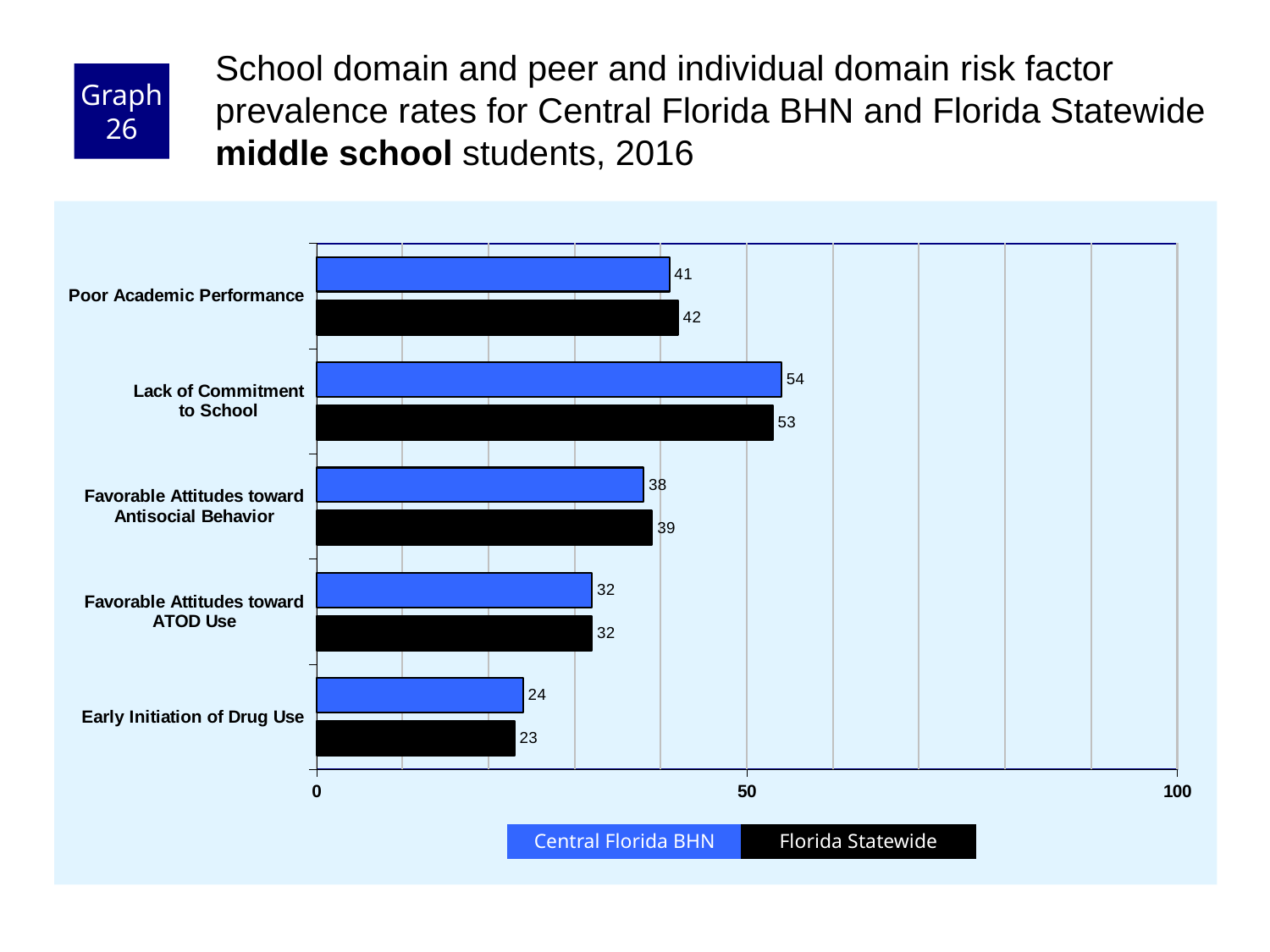
What is the difference between the Central Florida BHN values for Poor Academic Performance and Early Initiation of Drug Use? 17 What is the Central Florida BHN value for Lack of Commitment to School? 54 Which risk factor has the lowest Florida Statewide value? Early Initiation of Drug Use What is the Florida Statewide value for Early Initiation of Drug Use? 23 What is the difference between the Central Florida BHN and Florida Statewide values for Lack of Commitment to School? 1 What kind of chart is shown on the slide? bar chart How many risk factor categories are shown on the chart? 5 How many series does the legend list? 2 What is the Florida Statewide value for Favorable Attitudes toward Antisocial Behavior? 39 Which risk factor has the highest Central Florida BHN value? Lack of Commitment to School Which colour represents Florida Statewide in the chart? black Is the Central Florida BHN value for Lack of Commitment to School greater or less than 50? greater